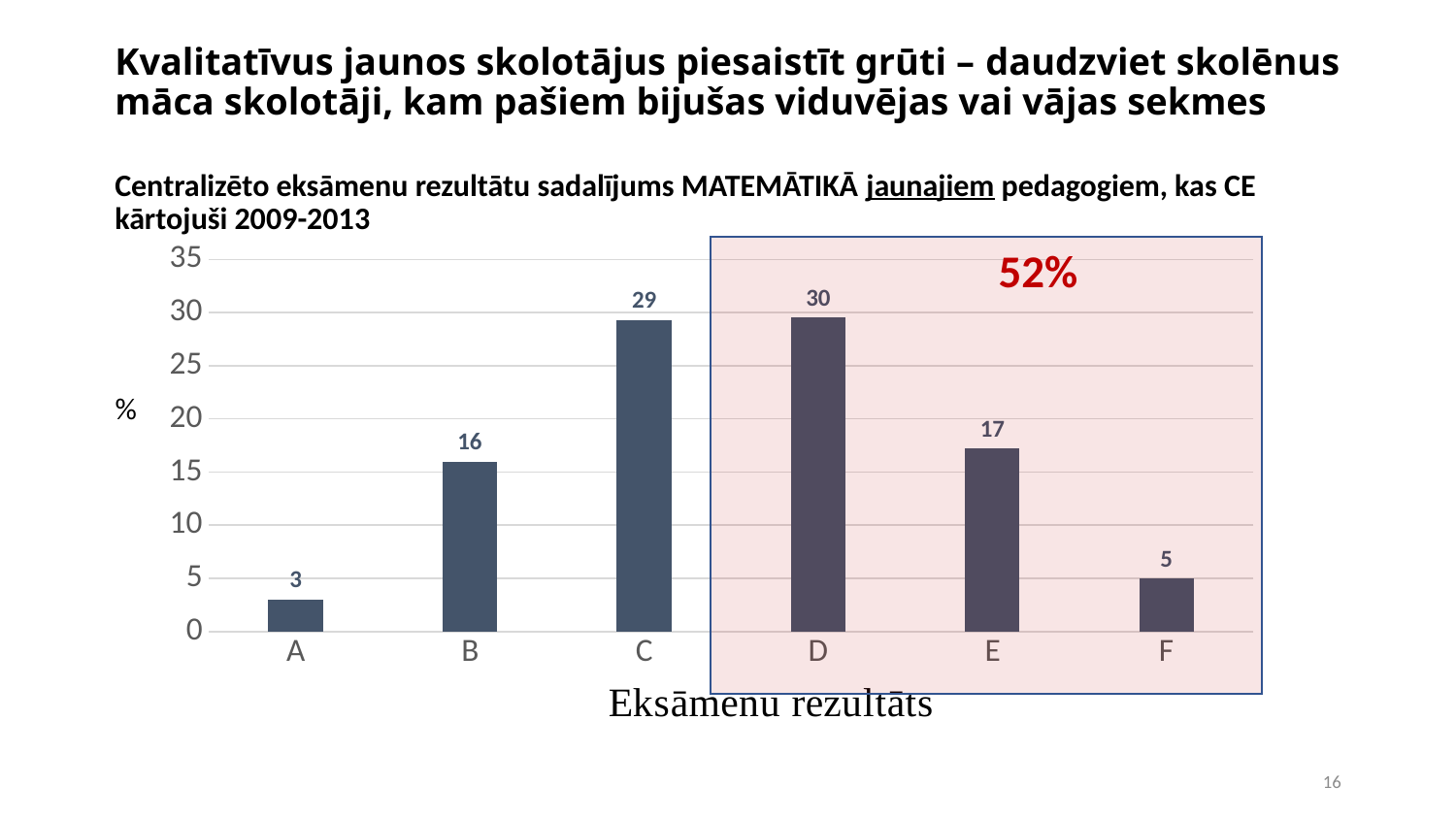
What is the value for category D? 30 How many categories are shown on the x axis? 6 What kind of chart is shown on the slide? bar chart What percentage is printed in red inside the highlighted box covering categories D, E and F? 52% What is the x-axis title of the chart? Eksāmenu rezultāts Which category has the highest value? D What is the difference between the values for C and E? 12 What is the value for category B? 16 What is the value for category F? 5 Is the value for C greater or less than 25? greater Which category has the lowest value? A Which is larger, the value for B or the value for E? E